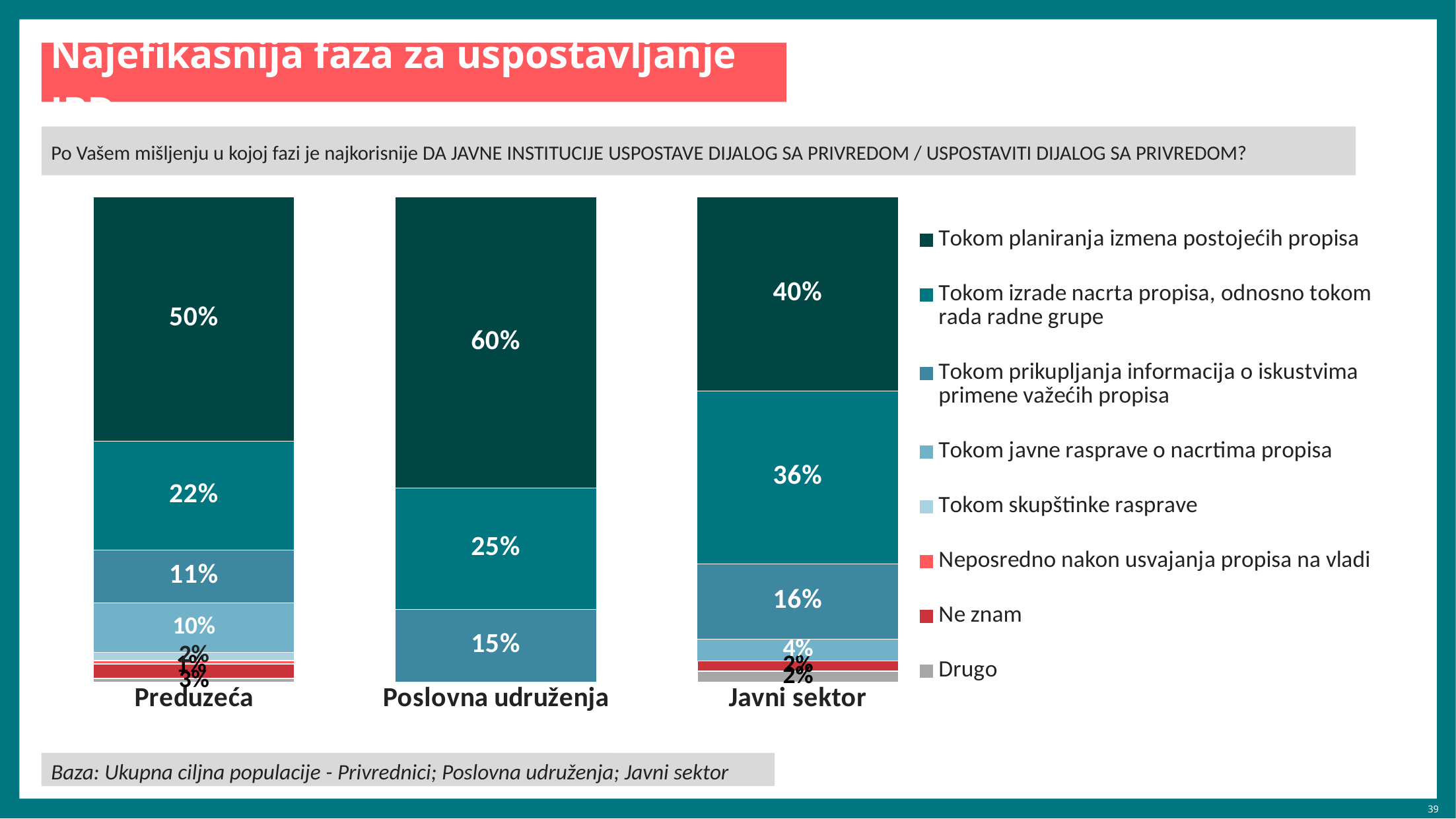
Which category has the lowest value for 'Tokom planiranja izmena postojećih propisa'? Javni sektor Which category has the highest value for 'Tokom planiranja izmena postojećih propisa'? Poslovna udruženja What kind of chart is shown on the slide? stacked bar chart How many series does the legend list? 8 Which legend entry is shown in grey? Drugo What is the value for 'Tokom prikupljanja informacija o iskustvima primene važećih propisa' in the Preduzeća bar? 11% How many categories are shown along the x axis? 3 What is the value for 'Tokom izrade nacrta propisa, odnosno tokom rada radne grupe' in the Javni sektor bar? 36% What is the difference between the 'Tokom izrade nacrta propisa, odnosno tokom rada radne grupe' values for Javni sektor and Preduzeća? 14% Which is larger: the 'Tokom prikupljanja informacija o iskustvima primene važećih propisa' value for Poslovna udruženja or for Javni sektor? Javni sektor What is the value for 'Tokom javne rasprave o nacrtima propisa' in the Javni sektor bar? 4% What is the value for 'Tokom planiranja izmena postojećih propisa' in the Poslovna udruženja bar? 60%